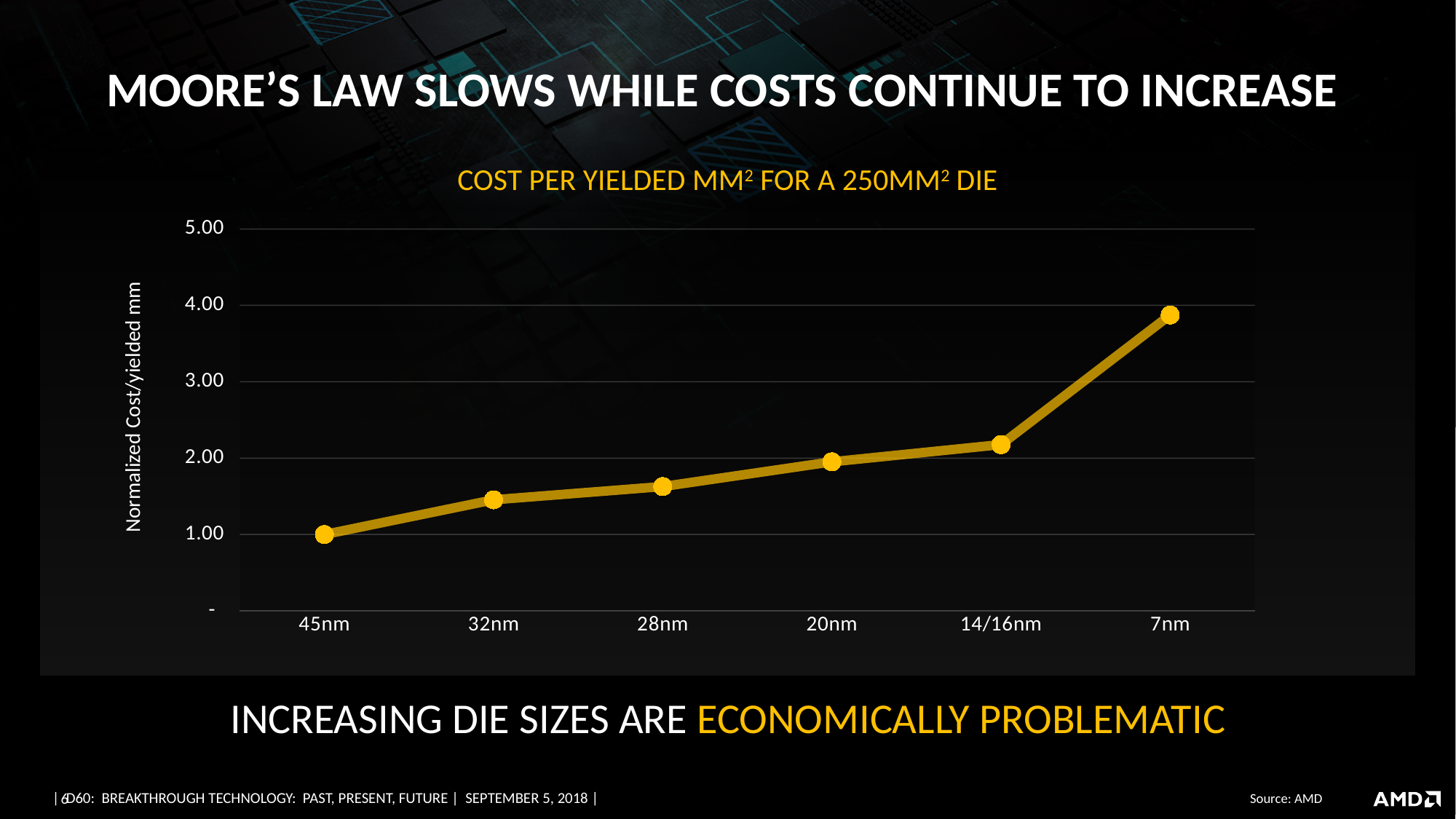
Which has a higher normalized cost per yielded mm, 28nm or 32nm? 28nm What is the title of the chart? COST PER YIELDED MM² FOR A 250MM² DIE How many process nodes are plotted on the x axis? 6 What is the label of the y axis? Normalized Cost/yielded mm Is the value for 14/16nm greater or less than 2.00? greater Which process node has the highest normalized cost per yielded mm? 7nm Which process node has the lowest normalized cost per yielded mm? 45nm What is the normalized cost per yielded mm for 45nm? 1.00 Is the value for 7nm greater or less than 3.00? greater Do the values rise or fall moving from 45nm to 7nm along the x axis? rise Is the value for 32nm greater or less than 2.00? less What kind of chart is shown on the slide? line chart